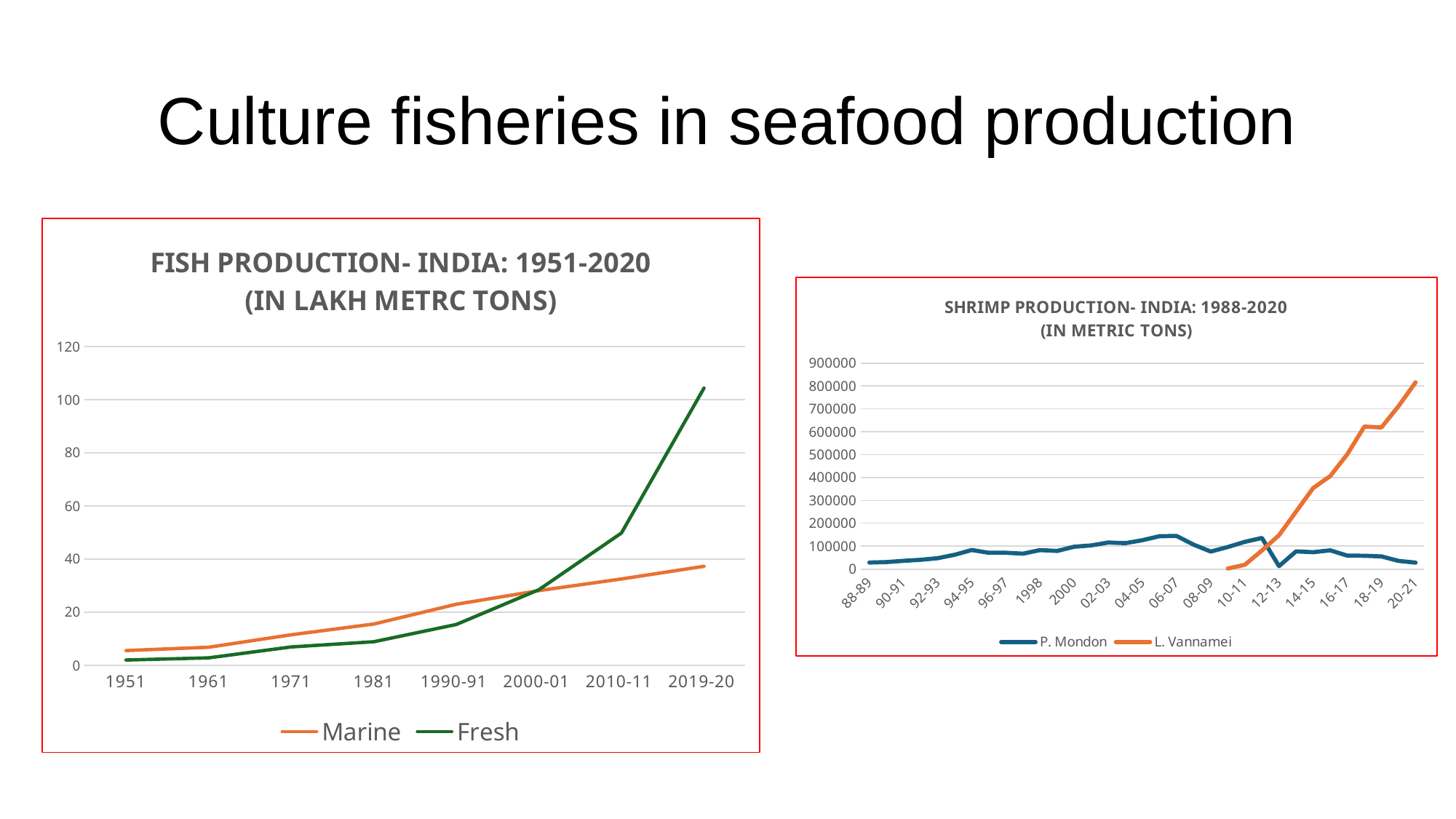
How many series does the legend of the 'FISH PRODUCTION- INDIA: 1951-2020' chart list? 2 In the 'FISH PRODUCTION- INDIA: 1951-2020' chart, is the Marine value for 2019-20 greater or less than 40? less How many time points are shown on the x axis of the 'FISH PRODUCTION- INDIA: 1951-2020' chart? 8 In the 'SHRIMP PRODUCTION- INDIA: 1988-2020' chart, is the L. Vannamei value for 20-21 greater or less than 700000? greater In the 'SHRIMP PRODUCTION- INDIA: 1988-2020' chart, does the L. Vannamei series rise or fall from 10-11 to 20-21? rise What type of chart is the 'FISH PRODUCTION- INDIA: 1951-2020' chart? line chart In the 'FISH PRODUCTION- INDIA: 1951-2020' chart, does the Fresh series rise or fall from 1951 to 2019-20? rise In the 'SHRIMP PRODUCTION- INDIA: 1988-2020' chart, which series is higher in 20-21, P. Mondon or L. Vannamei? L. Vannamei What are the two series listed in the legend of the 'SHRIMP PRODUCTION- INDIA: 1988-2020' chart? P. Mondon and L. Vannamei In the 'FISH PRODUCTION- INDIA: 1951-2020' chart, which series is higher in 1981, Marine or Fresh? Marine In the 'FISH PRODUCTION- INDIA: 1951-2020' chart, which series is higher in 2019-20, Marine or Fresh? Fresh In the 'FISH PRODUCTION- INDIA: 1951-2020' chart, is the Fresh value for 2019-20 greater or less than 100? greater